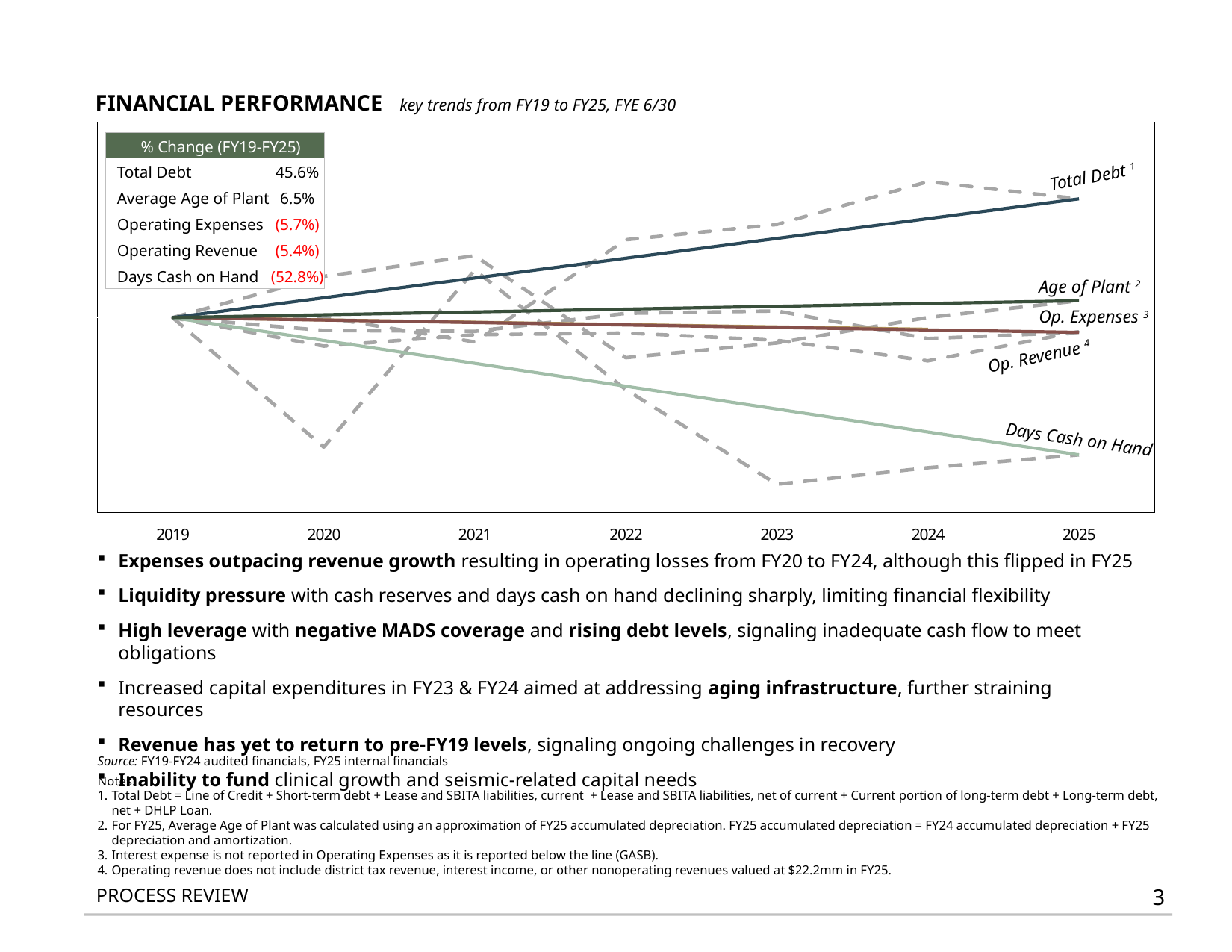
What is the % change (FY19-FY25) for Average Age of Plant shown in the table on the chart? 6.5% Which metric in the % Change (FY19-FY25) table has the largest increase? Total Debt What is the first year shown on the x axis of the chart? 2019 What is the % change (FY19-FY25) for Days Cash on Hand shown in the table on the chart? (52.8%) Does the Total Debt trend line rise or fall from 2019 to 2025? Rise What is the % change (FY19-FY25) for Operating Revenue shown in the table on the chart? (5.4%) What kind of chart is shown on the slide? Line chart What is the % change (FY19-FY25) for Total Debt shown in the table on the chart? 45.6% How many labeled series (solid trend lines) does the chart show? 5 Which metric in the % Change (FY19-FY25) table has the largest decline? Days Cash on Hand How many years are shown along the x axis of the chart? 7 Does the Days Cash on Hand trend line rise or fall from 2019 to 2025? Fall